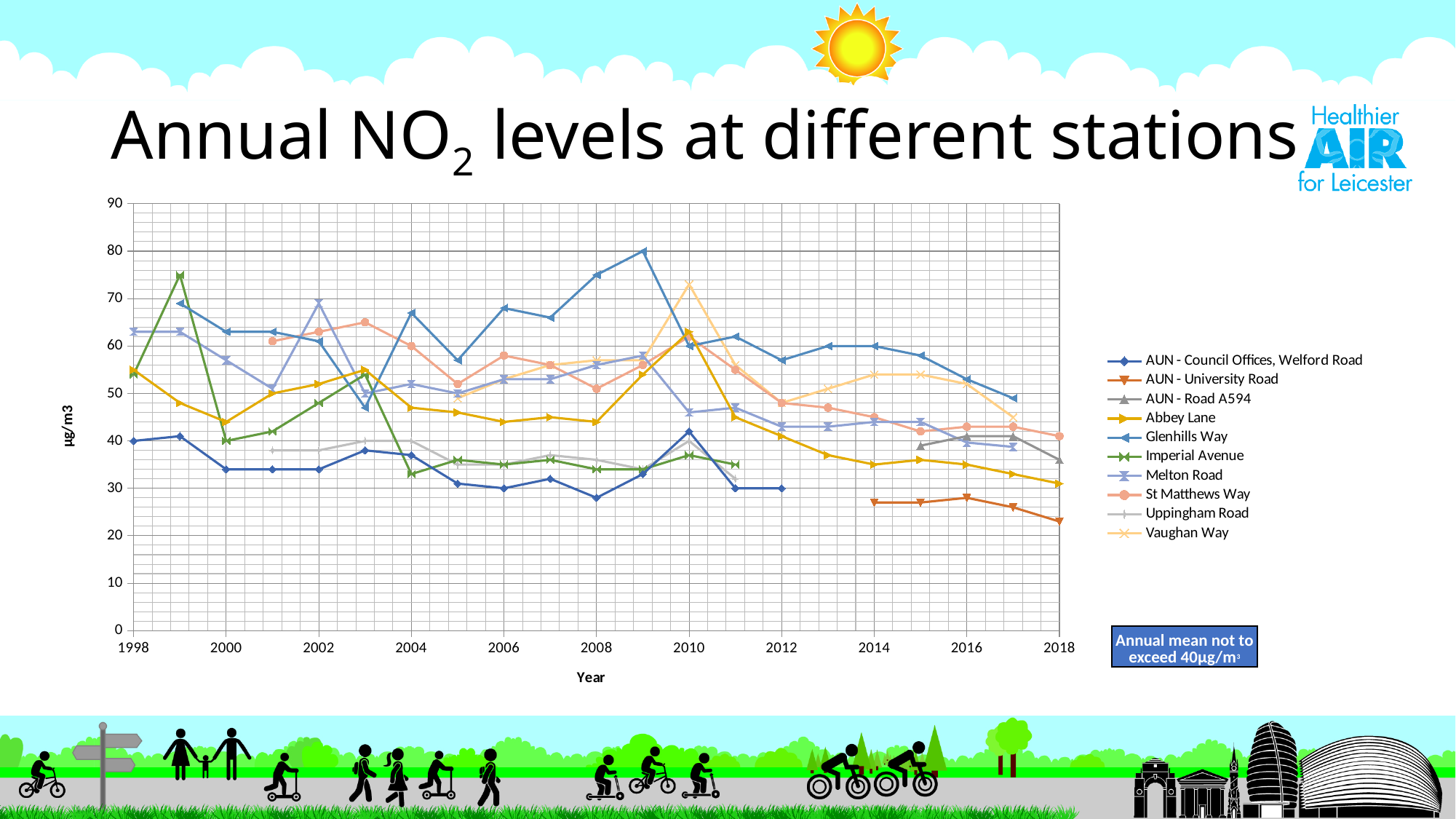
Is the value for AUN - University Road in 2018 greater or less than 30? less Is the value for Abbey Lane in 2018 greater or less than 40? less Which series reaches the highest value anywhere on the chart? Glenhills Way How many series does the legend list? 10 Do the values for Abbey Lane rise or fall from 2010 to 2018? fall What kind of chart is shown on the slide? Line chart In 2010, which is larger: the value for Glenhills Way or the value for AUN - Council Offices, Welford Road? Glenhills Way Is the value for Imperial Avenue in 1999 greater or less than 70? greater What is the title of the chart on the slide? Annual NO2 levels at different stations What is the label on the y axis of the chart? µg/m3